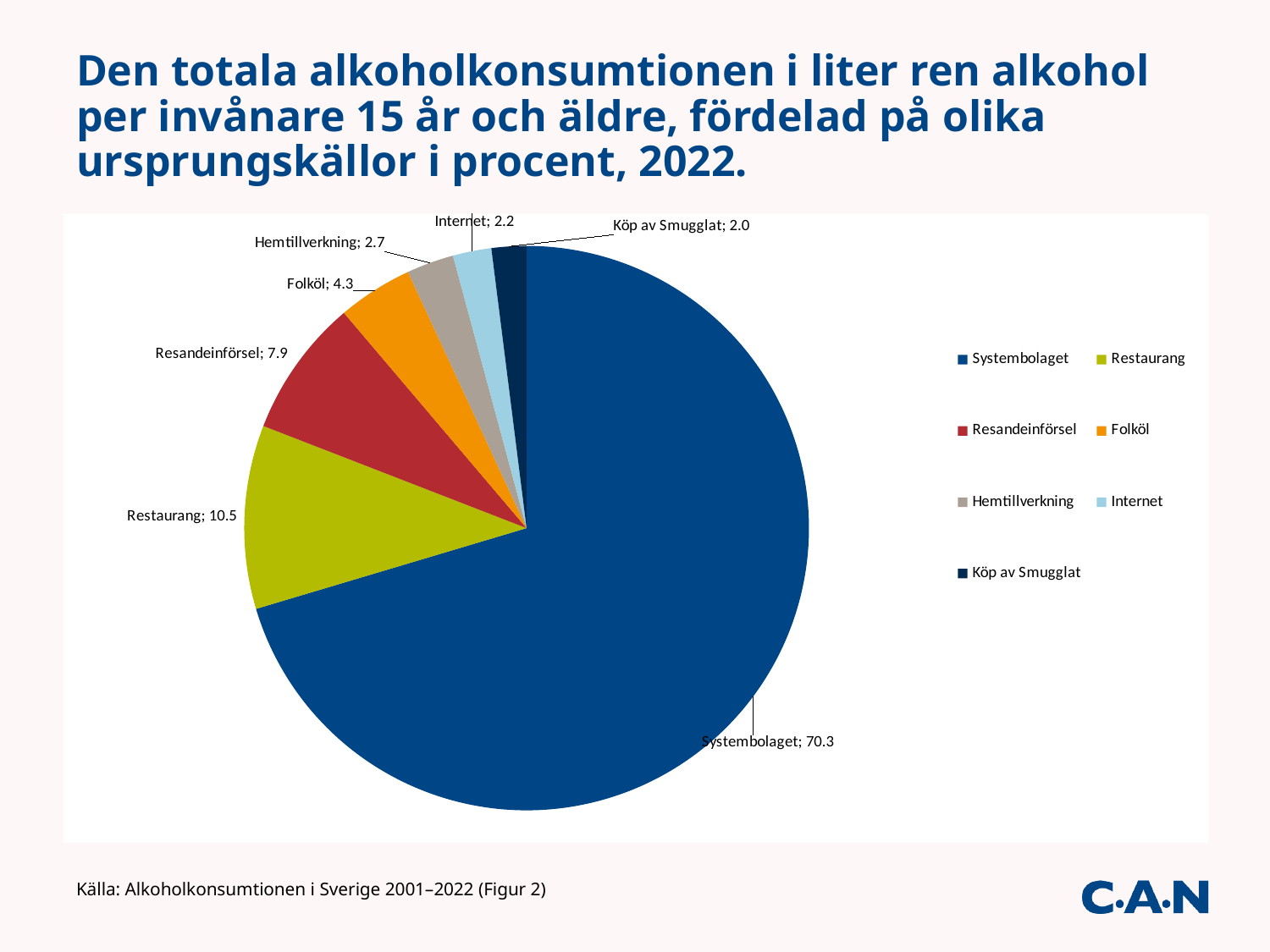
Which category has the largest slice of the pie? Systembolaget What is the value shown for Resandeinförsel? 7.9 What is the value shown for Restaurang? 10.5 Which is larger, the value for Hemtillverkning or the value for Internet? Hemtillverkning What is the value shown for Systembolaget? 70.3 How many entries does the legend list? 7 What type of chart is shown on the slide? Pie chart How many categories are shown in the pie chart? 7 Which category has the smallest slice of the pie? Köp av Smugglat What is the value shown for Folköl? 4.3 What is the value shown for Köp av Smugglat? 2.0 What is the difference between the values for Restaurang and Resandeinförsel? 2.6